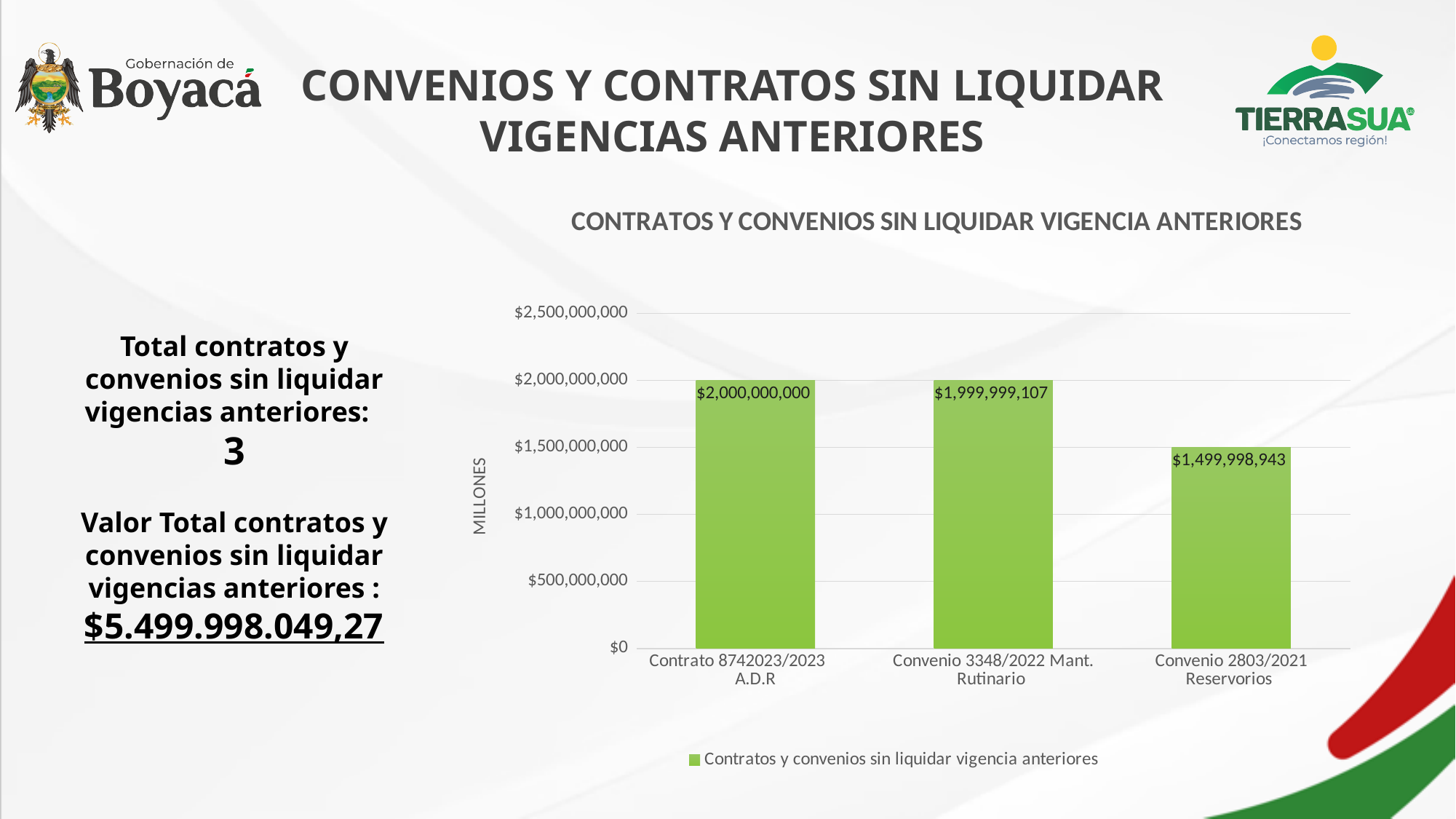
Which is larger, the value for Convenio 3348/2022 Mant. Rutinario or the value for Convenio 2803/2021 Reservorios? Convenio 3348/2022 Mant. Rutinario Is the value for Convenio 2803/2021 Reservorios greater or less than $1,000,000,000? greater How many categories are shown on the x axis? 3 Which category has the highest value? Contrato 8742023/2023 A.D.R What is the value for Convenio 3348/2022 Mant. Rutinario? $1,999,999,107 How many series does the legend list? 1 What is the difference between the values for Contrato 8742023/2023 A.D.R and Convenio 2803/2021 Reservorios? $500,001,057 What is the title of the chart? CONTRATOS Y CONVENIOS SIN LIQUIDAR VIGENCIA ANTERIORES What is the value for Convenio 2803/2021 Reservorios? $1,499,998,943 Which category has the lowest value? Convenio 2803/2021 Reservorios What kind of chart is shown? bar chart What is the value for Contrato 8742023/2023 A.D.R? $2,000,000,000